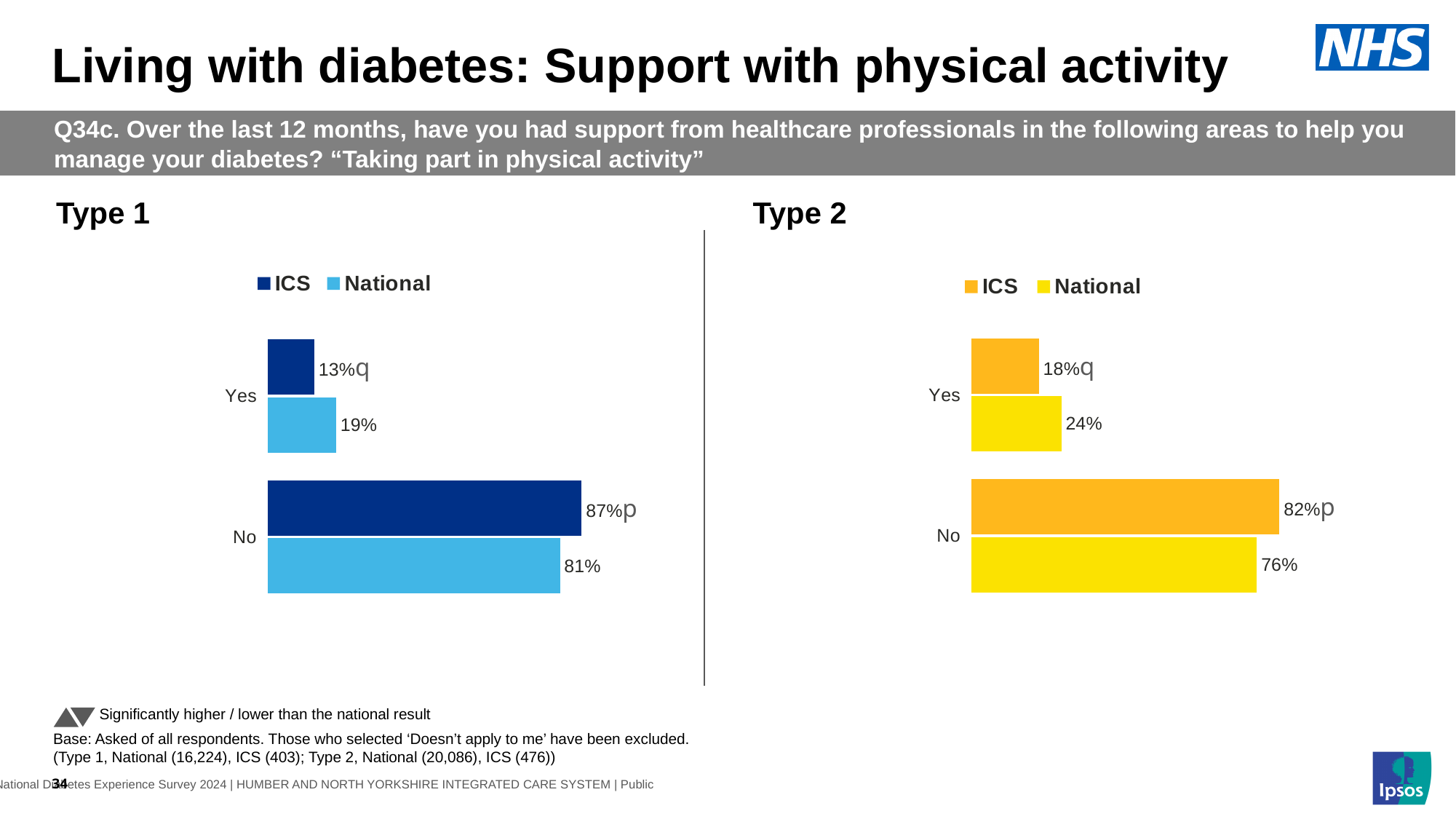
What kind of chart is the Type 1 chart? Bar chart In the Type 2 chart, what colour represents the National series? Yellow In the Type 2 chart, what is the difference between the National and ICS values for Yes? 6% In the Type 2 chart, what is the ICS value for Yes? 18% In the Type 1 chart, what is the National value for No? 81% In the Type 1 chart, which series has the highest value overall? ICS (No, 87%) In the Type 2 chart, what is the National value for No? 76% In the Type 1 chart, what is the difference between the ICS and National values for No? 6% In the Type 1 chart, which is larger for Yes: ICS or National? National In the Type 2 chart, which is larger for No: ICS or National? ICS In the Type 2 chart, how many series does the legend list? 2 In the Type 1 chart, what is the ICS value for Yes? 13%